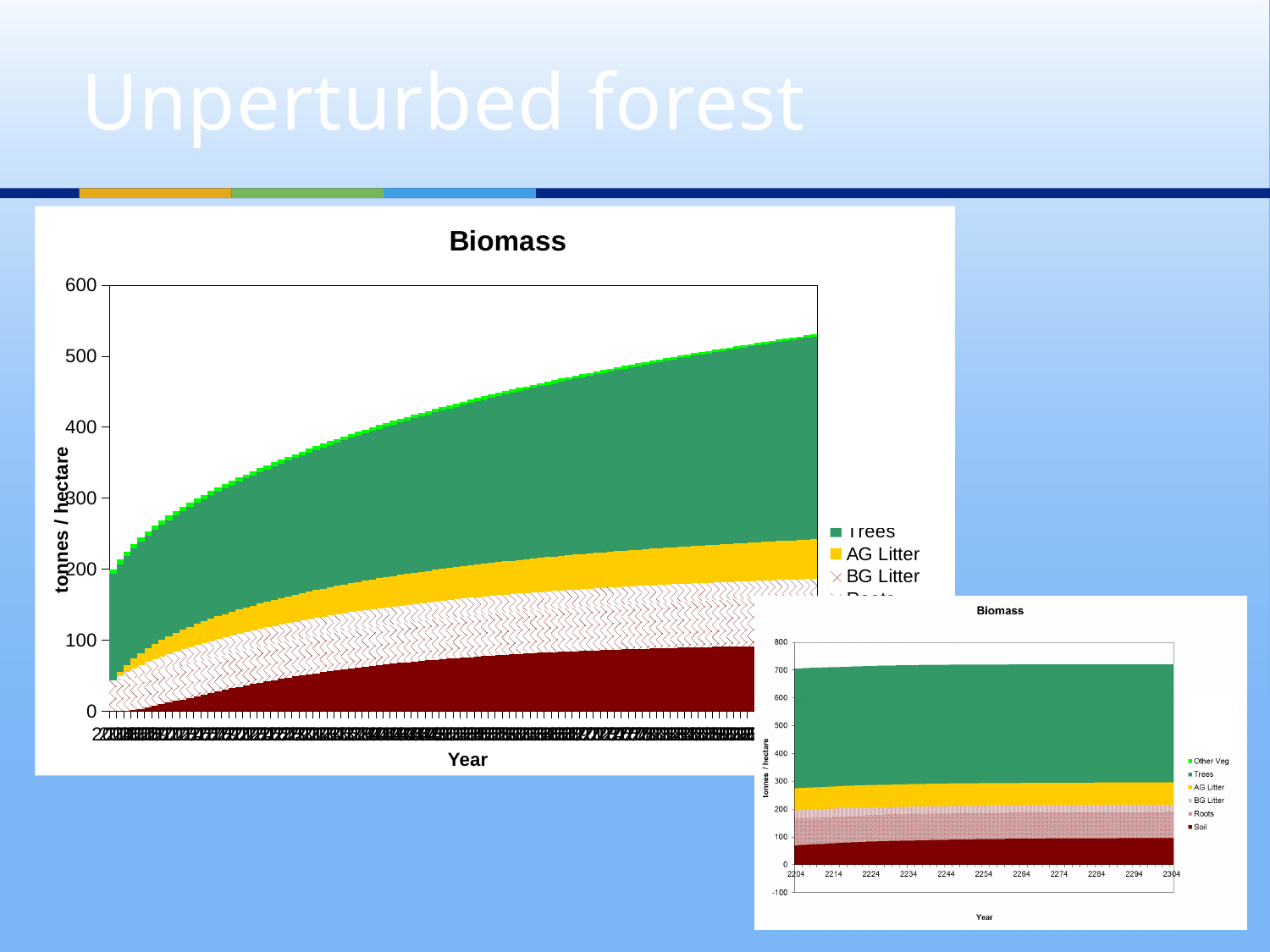
In the small Biomass chart in the bottom right, is the total biomass greater or less than 600? greater In the small Biomass chart in the bottom right, is the total biomass greater or less than 800? less In the large Biomass chart on the left, which series occupies the largest band? Trees In the large Biomass chart on the left, do the total biomass values rise or fall along the x axis? rise What is the y-axis title of the large Biomass chart on the left? tonnes / hectare In the large Biomass chart on the left, which band is larger, Trees or AG Litter? Trees What kind of chart is the large Biomass chart on the left of the slide? stacked bar chart How many series does the legend of the small Biomass chart in the bottom right list? 6 In the large Biomass chart on the left, is the total biomass at the right end of the x axis greater or less than 500? greater In the small Biomass chart in the bottom right, which series occupies the largest band? Trees What is the first year label on the x axis of the small Biomass chart in the bottom right? 2204